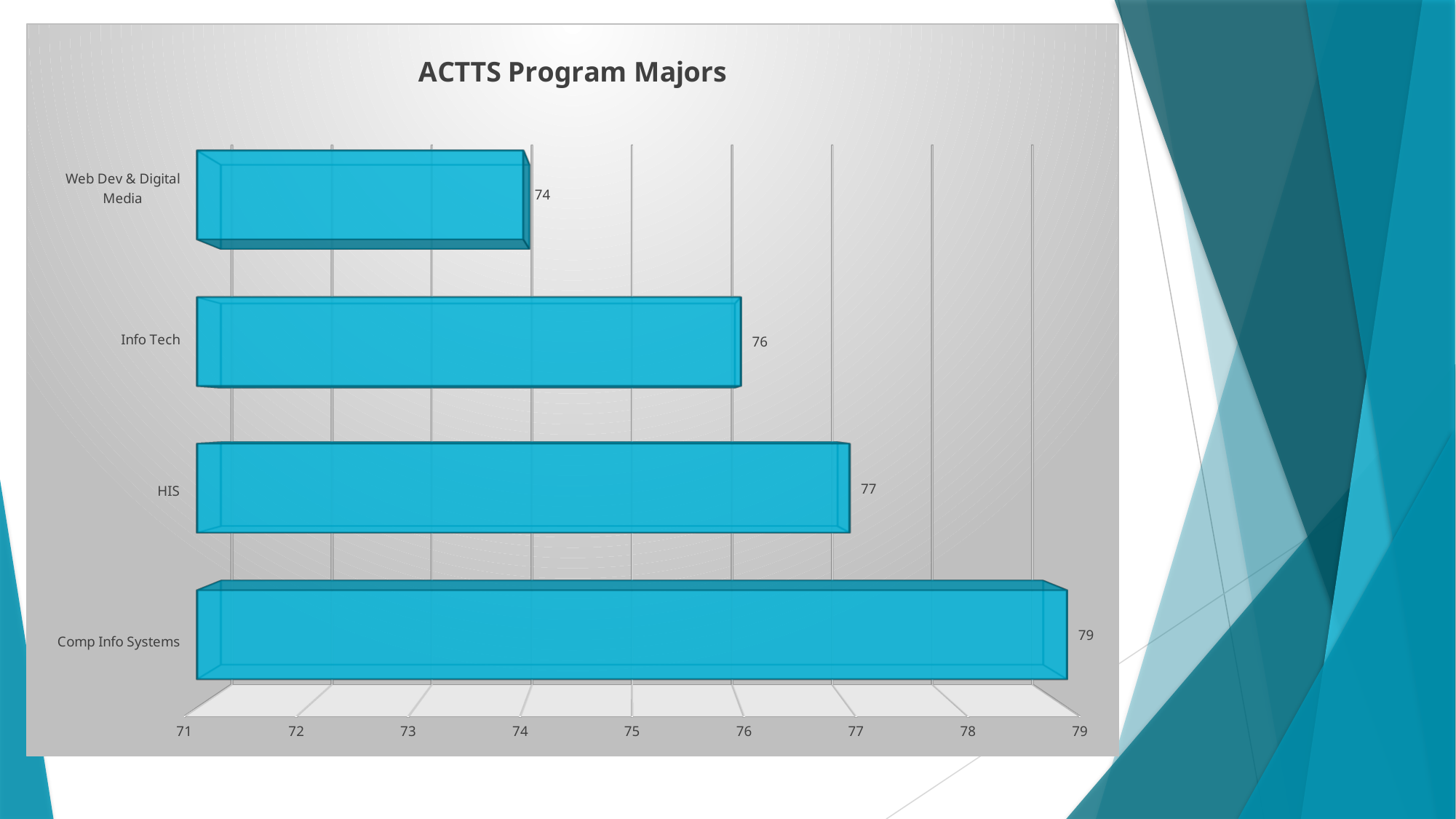
Which is larger, the value for Info Tech or the value for Web Dev & Digital Media? Info Tech How many categories are shown in the chart? 4 What is the value for Info Tech? 76 What is the value for Comp Info Systems? 79 What kind of chart is shown on the slide? Bar chart What is the value for HIS? 77 Which category has the lowest value? Web Dev & Digital Media Which category has the highest value? Comp Info Systems What is the difference between the values for HIS and Info Tech? 1 What is the difference between the values for Comp Info Systems and Web Dev & Digital Media? 5 What is the title of the chart? ACTTS Program Majors What is the value for Web Dev & Digital Media? 74